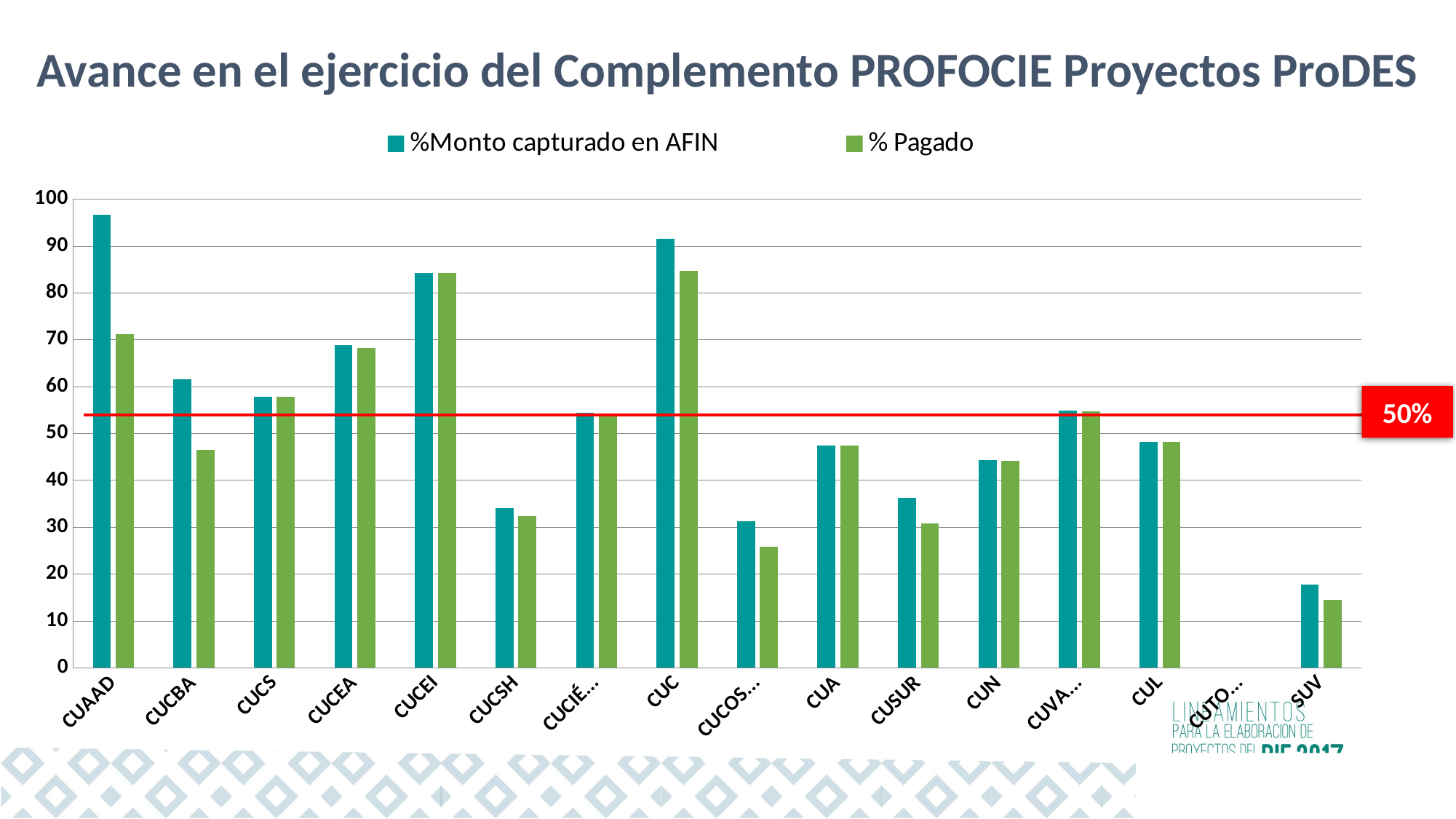
For CUCBA, which is larger: %Monto capturado en AFIN or % Pagado? %Monto capturado en AFIN Is the % Pagado value for CUC greater or less than 80? greater How many categories are labelled on the x axis? 16 What kind of chart is shown on the slide? bar chart Which category has the highest value for %Monto capturado en AFIN? CUAAD Is the %Monto capturado en AFIN value for SUV greater or less than 20? less Is the % Pagado value for CUCBA greater or less than 50? less Which has the larger %Monto capturado en AFIN value, CUCEA or CUCEI? CUCEI What label is shown on the red horizontal line across the chart? 50% How many series does the legend list? 2